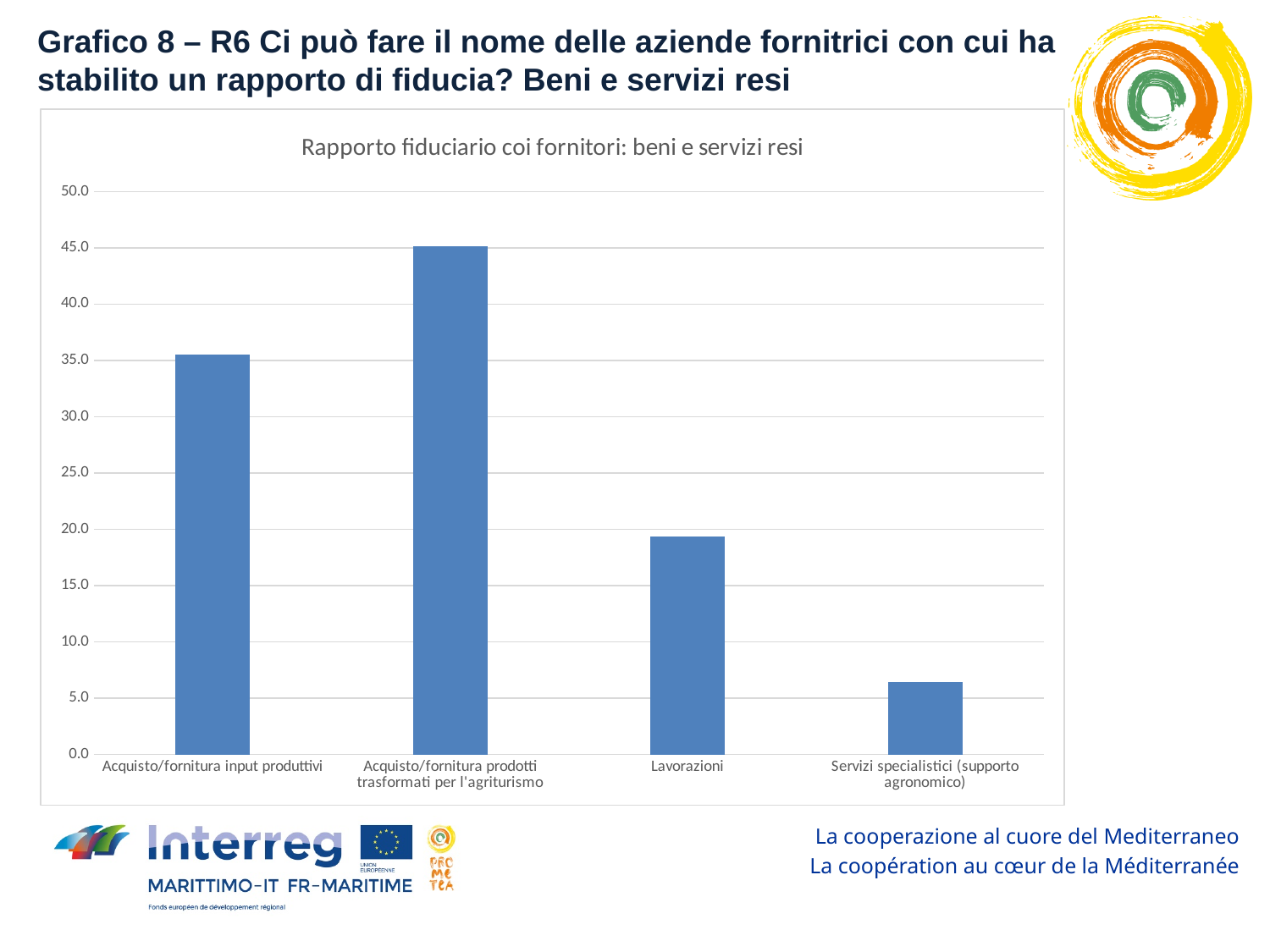
Which category has the highest value? Acquisto/fornitura prodotti trasformati per l'agriturismo What is the maximum value shown on the y axis of the chart? 50.0 Is the value for Acquisto/fornitura input produttivi greater or less than 30.0? greater Which is larger, the value for Lavorazioni or the value for Acquisto/fornitura input produttivi? Acquisto/fornitura input produttivi What is the title of the chart? Rapporto fiduciario coi fornitori: beni e servizi resi How many categories are shown on the x axis of the chart? 4 What kind of chart is shown on the slide? bar chart Which is larger, the value for Servizi specialistici (supporto agronomico) or the value for Lavorazioni? Lavorazioni Is the value for Lavorazioni greater or less than 20.0? less Is the value for Servizi specialistici (supporto agronomico) greater or less than 10.0? less Which category has the lowest value? Servizi specialistici (supporto agronomico)